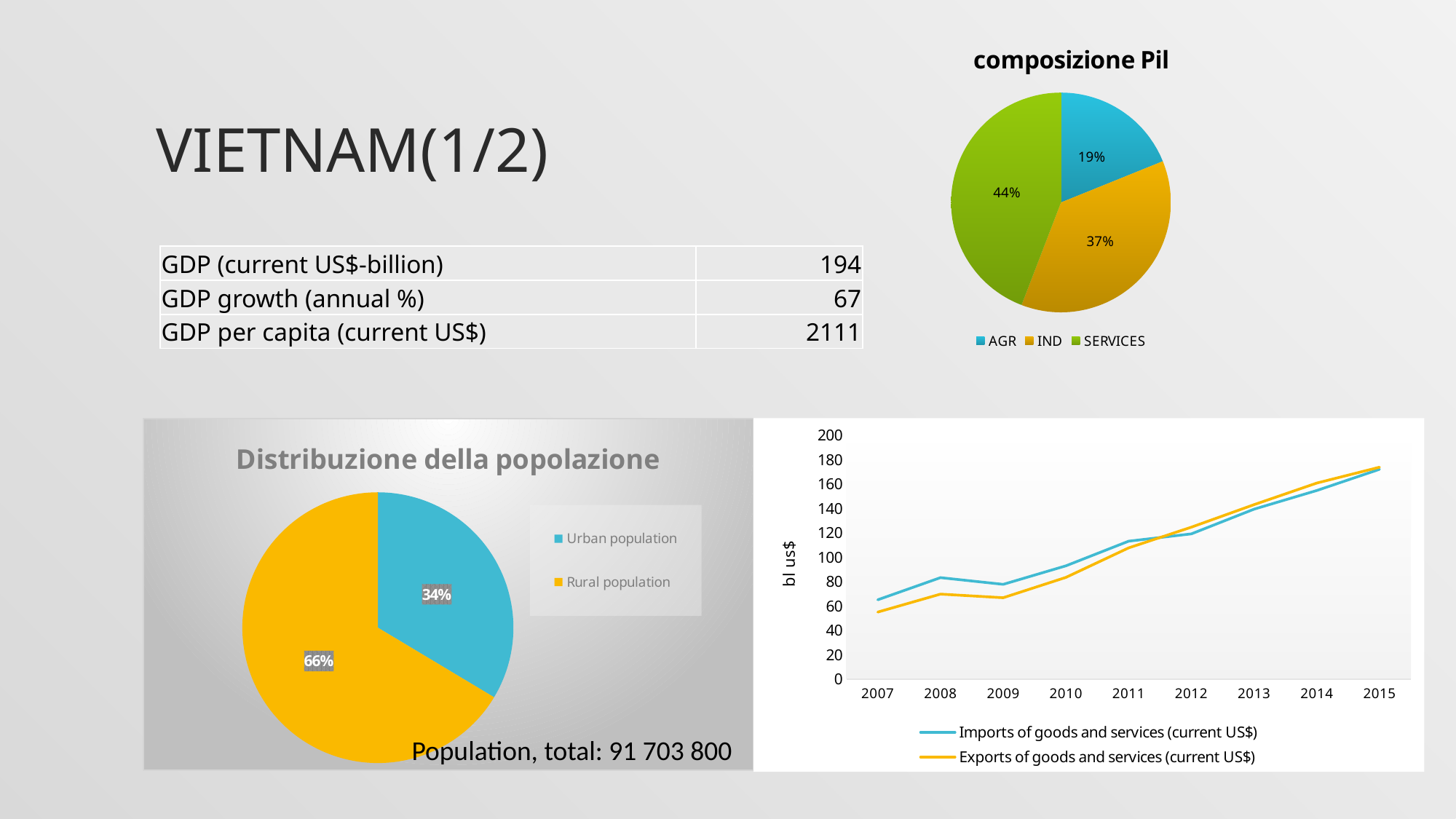
In the line chart at the bottom right, how many series does the legend list? 2 In the 'composizione Pil' pie chart, what is the difference in percentage points between IND and AGR? 18 In the line chart at the bottom right, do the Imports of goods and services generally rise or fall from 2007 to 2015? Rise In the 'composizione Pil' pie chart, which sector has the smallest share? AGR How many slices does the 'composizione Pil' pie chart have? 3 In the line chart at the bottom right, is the value for Exports of goods and services in 2015 greater or less than 160? greater In the 'composizione Pil' pie chart, what share does AGR have? 19% In the 'Distribuzione della popolazione' chart, which is larger, Urban population or Rural population? Rural population What kind of chart is 'Distribuzione della popolazione'? Pie chart In the 'composizione Pil' pie chart, which sector has the largest share? SERVICES In the 'composizione Pil' pie chart, what share does SERVICES have? 44% In the 'Distribuzione della popolazione' chart, what share is Rural population? 66%